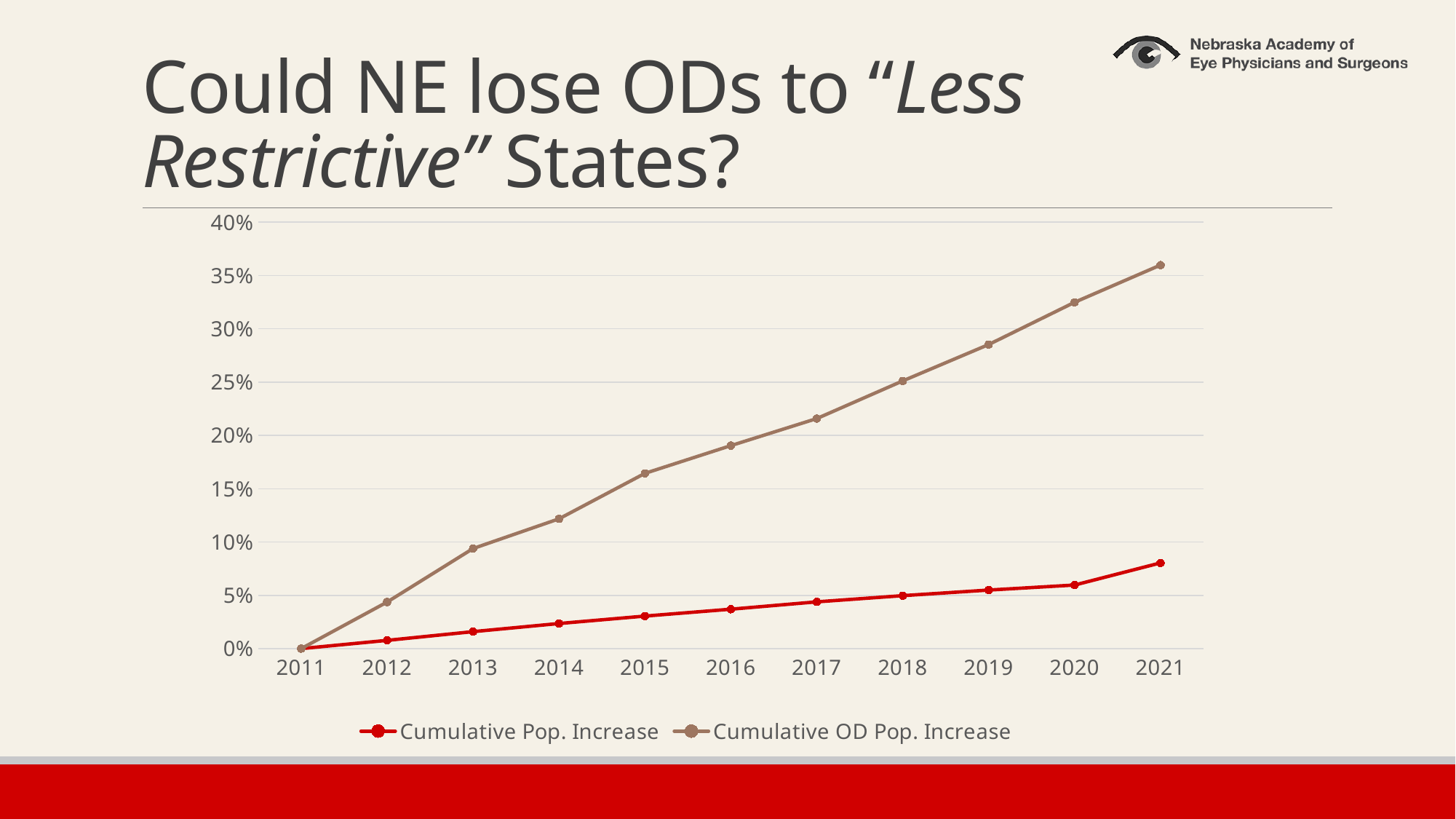
What kind of chart is shown on the slide? Line chart How many series does the legend list? 2 Is the value for Cumulative OD Pop. Increase in 2021 greater or less than 30%? greater In which year is Cumulative Pop. Increase lowest? 2011 Does the Cumulative OD Pop. Increase line rise or fall from 2011 to 2021? Rise Is the value for Cumulative OD Pop. Increase in 2016 greater or less than 15%? greater How many years are plotted along the x axis? 11 What is the value of Cumulative OD Pop. Increase in 2011? 0% What colour is the Cumulative Pop. Increase line? Red In 2021, which series has the higher value, Cumulative Pop. Increase or Cumulative OD Pop. Increase? Cumulative OD Pop. Increase Is the value for Cumulative Pop. Increase in 2021 greater or less than 10%? less In which year is Cumulative OD Pop. Increase highest? 2021